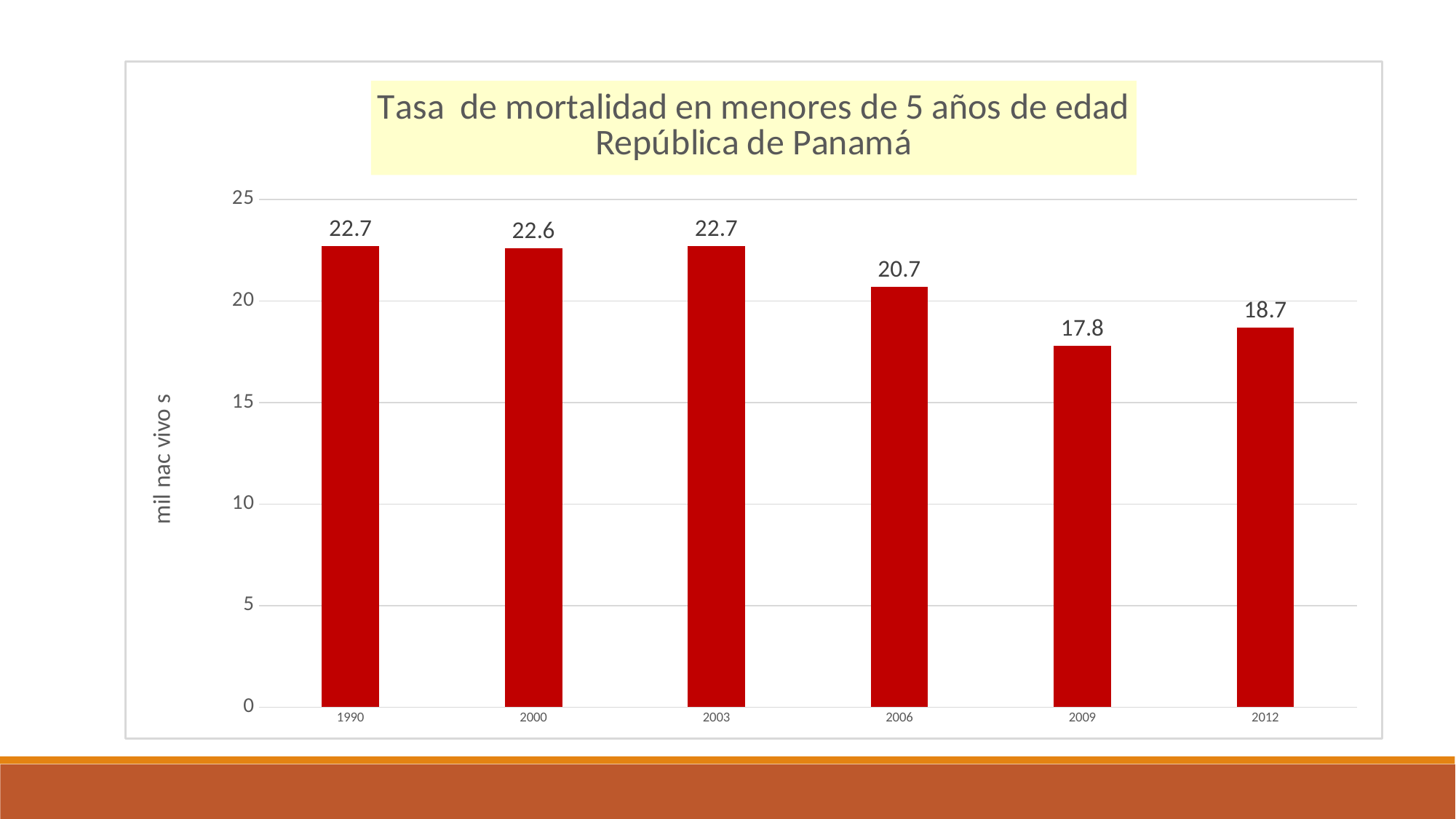
What is the value for 1990? 22.7 What is the difference between the values for 2003 and 2009? 4.9 What is the title of the chart? Tasa de mortalidad en menores de 5 años de edad República de Panamá Which year has the lowest value? 2009 What is the value for 2012? 18.7 What kind of chart is shown? bar chart How many years are shown on the x axis? 6 What is the value for 2006? 20.7 Which is larger, the value for 2009 or the value for 2012? 2012 Do the values generally rise or fall from 2003 to 2009? fall What is the difference between the values for 2006 and 2012? 2 Is the value for 2009 greater or less than 20? less